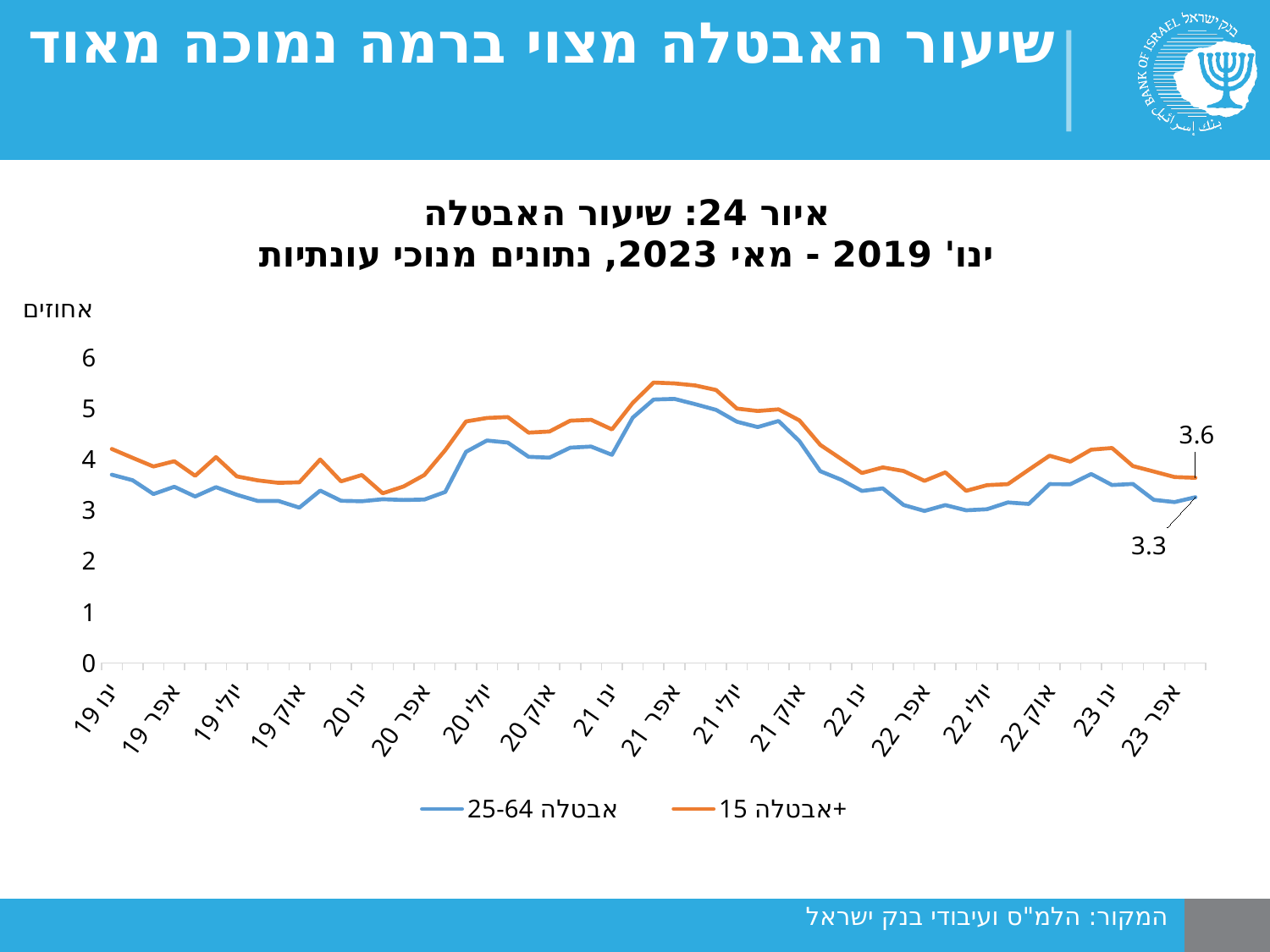
How many series does the legend list? 2 Which series is drawn in orange? אבטלה 15+ Do the values of both series rise or fall between אפר 21 and ינו 22? fall Is the value of the אבטלה 25-64 series at ינו 19 greater or less than 3? greater What kind of chart is shown on the slide? line chart Is the peak value of the אבטלה 15+ series around אפר 21 greater or less than 5? greater What is the label on the vertical axis? אחוזים What is the last labelled value for the אבטלה 25-64 series? 3.3 What is the last labelled value for the אבטלה 15+ series? 3.6 What is the difference between the final labelled values of the אבטלה 15+ and אבטלה 25-64 series? 0.3 At the end of the period, which series has the higher value, אבטלה 15+ or אבטלה 25-64? אבטלה 15+ Is the value of the אבטלה 15+ series at ינו 19 greater or less than 4? greater